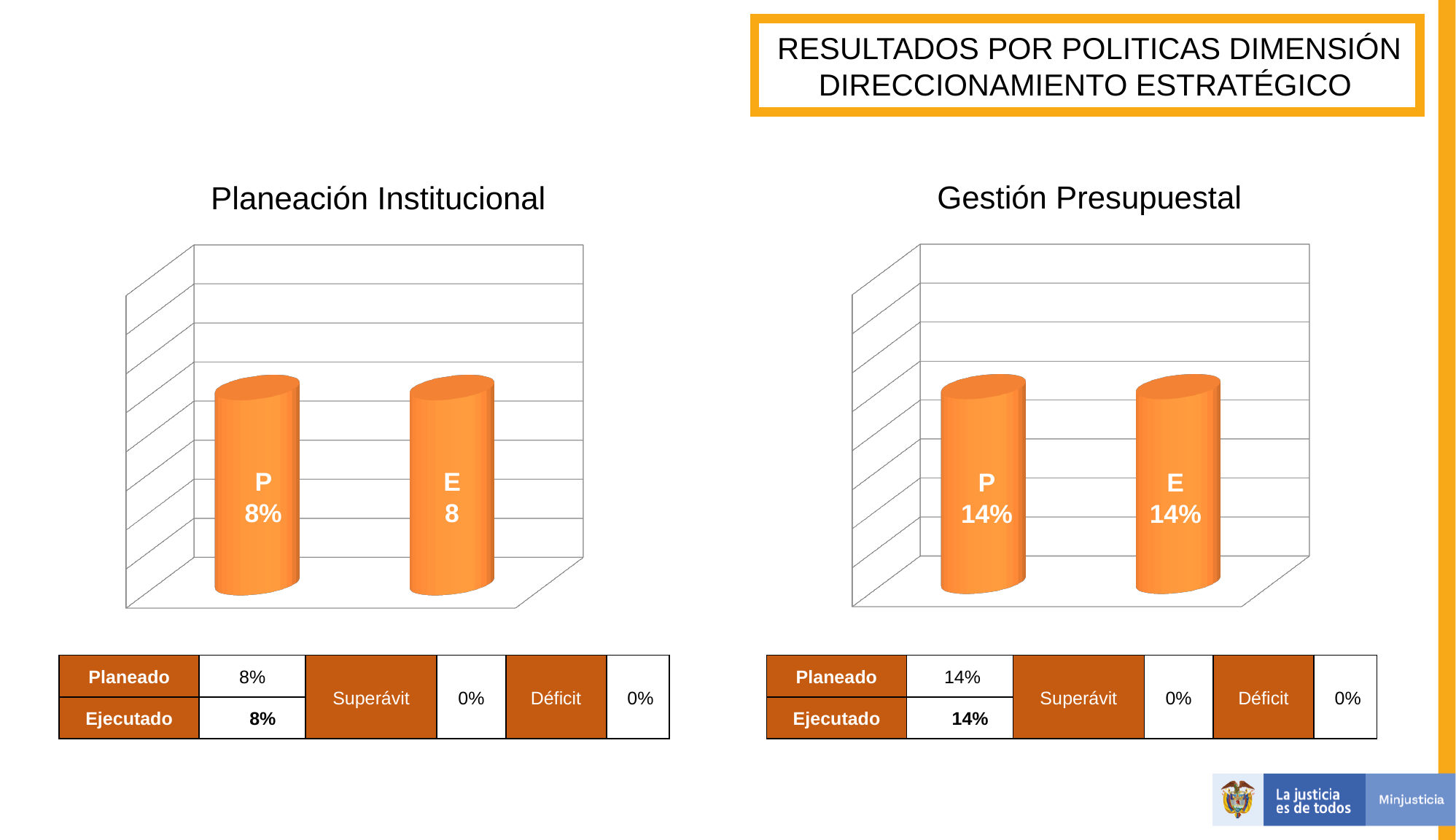
What is the title of the chart on the right side of the slide? Gestión Presupuestal What kind of chart is the Planeación Institucional chart? Bar chart In the Planeación Institucional chart, what value is printed on the P bar? 8% In the Planeación Institucional chart, what value is printed on the E bar? 8 In the Gestión Presupuestal chart, what is the difference between the P value and the E value? 0% What kind of chart is the Gestión Presupuestal chart? Bar chart In the Gestión Presupuestal chart, what value is printed on the P bar? 14% What is the title of the chart on the left side of the slide? Planeación Institucional Is the P value in the Gestión Presupuestal chart larger than the P value in the Planeación Institucional chart? Yes In the Gestión Presupuestal chart, what value is printed on the E bar? 14% How many bars does the Planeación Institucional chart show? 2 How many bars does the Gestión Presupuestal chart show? 2